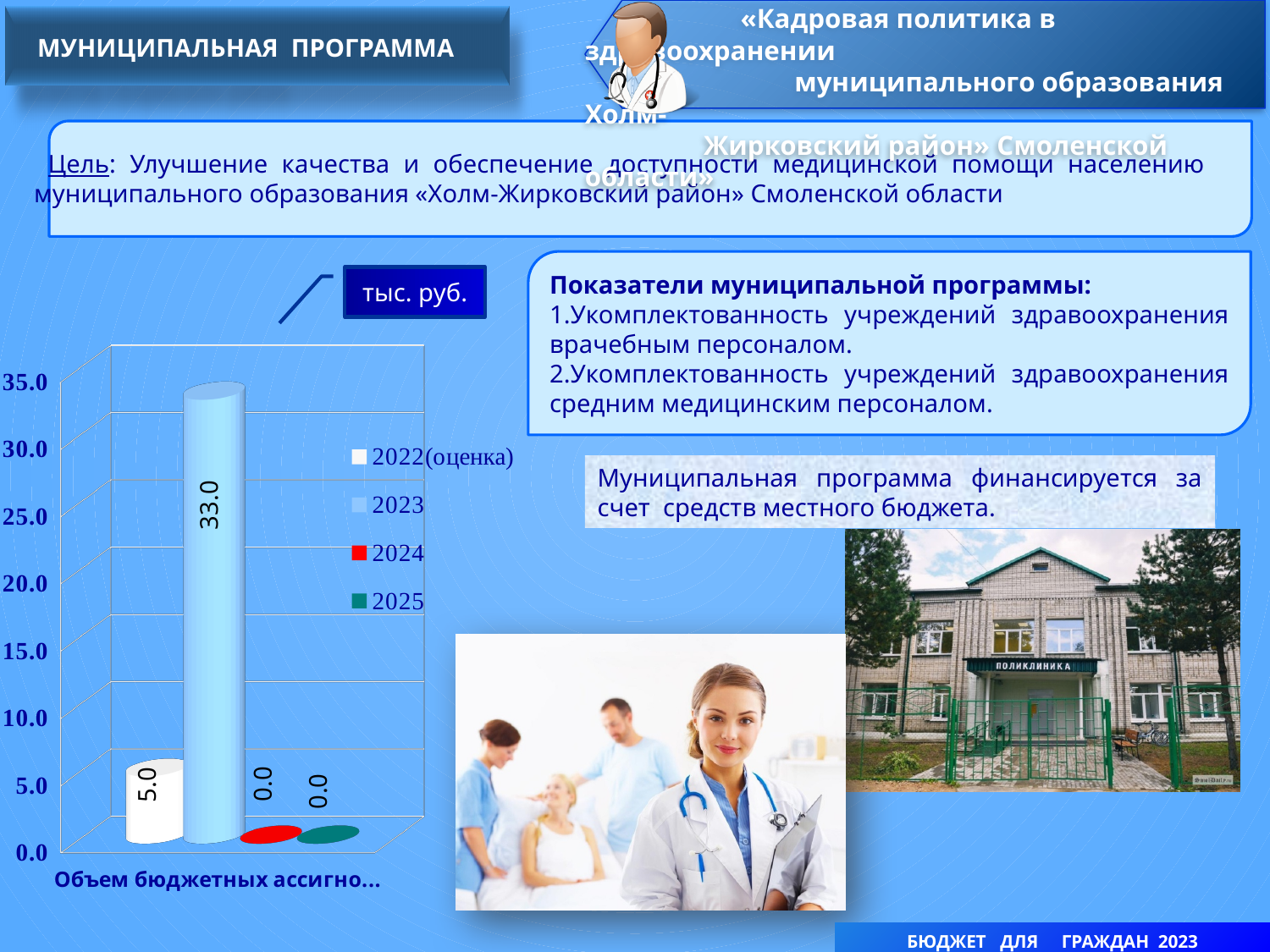
What is the value for 2025 in the chart? 0.0 What kind of chart is shown on the slide? bar chart What is the value for 2022(оценка) in the chart? 5.0 What unit of measurement is indicated for the chart? тыс. руб. Is the value for 2023 greater or less than 30.0? greater What is the value for 2024 in the chart? 0.0 Which series has the highest value in the chart? 2023 How many series does the chart legend list? 4 What colour is the 2024 series in the chart legend? red What is the difference between the values for 2023 and 2022(оценка)? 28.0 What is the value for 2023 in the chart? 33.0 Which is larger, the value for 2022(оценка) or the value for 2023? 2023